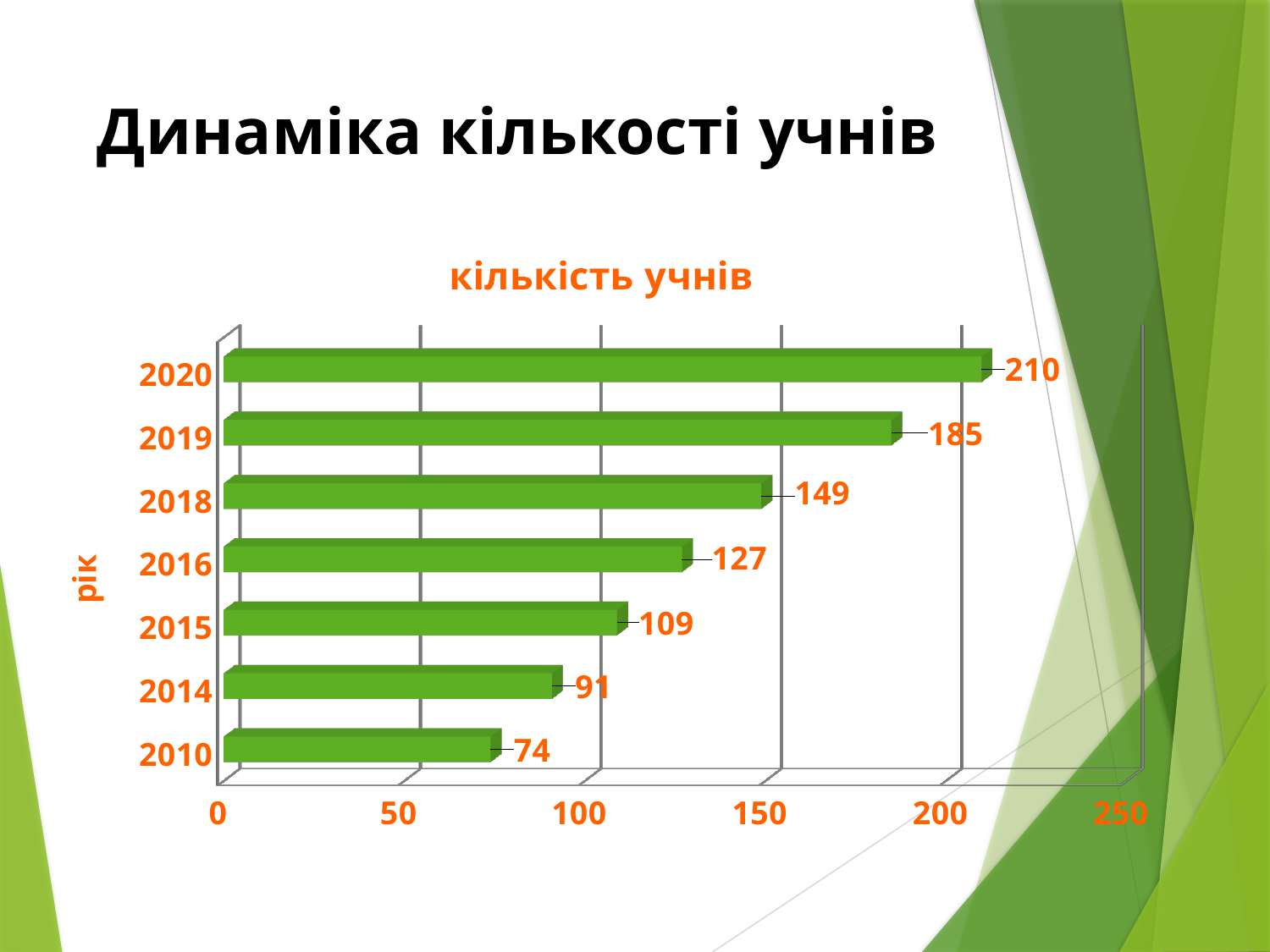
What is the number of students (кількість учнів) for 2020? 210 What is the difference between the number of students in 2019 and in 2018? 36 Which year has the lowest number of students? 2010 Which year has more students, 2015 or 2016? 2016 Which year has the highest number of students? 2020 What is the number of students for 2014? 91 How many years are shown in the chart? 7 Is the value for 2018 greater or less than 100? greater What is the difference between the number of students in 2020 and in 2010? 136 What kind of chart is shown on the slide? Bar chart What is the title of the chart? кількість учнів What is the number of students for 2016? 127